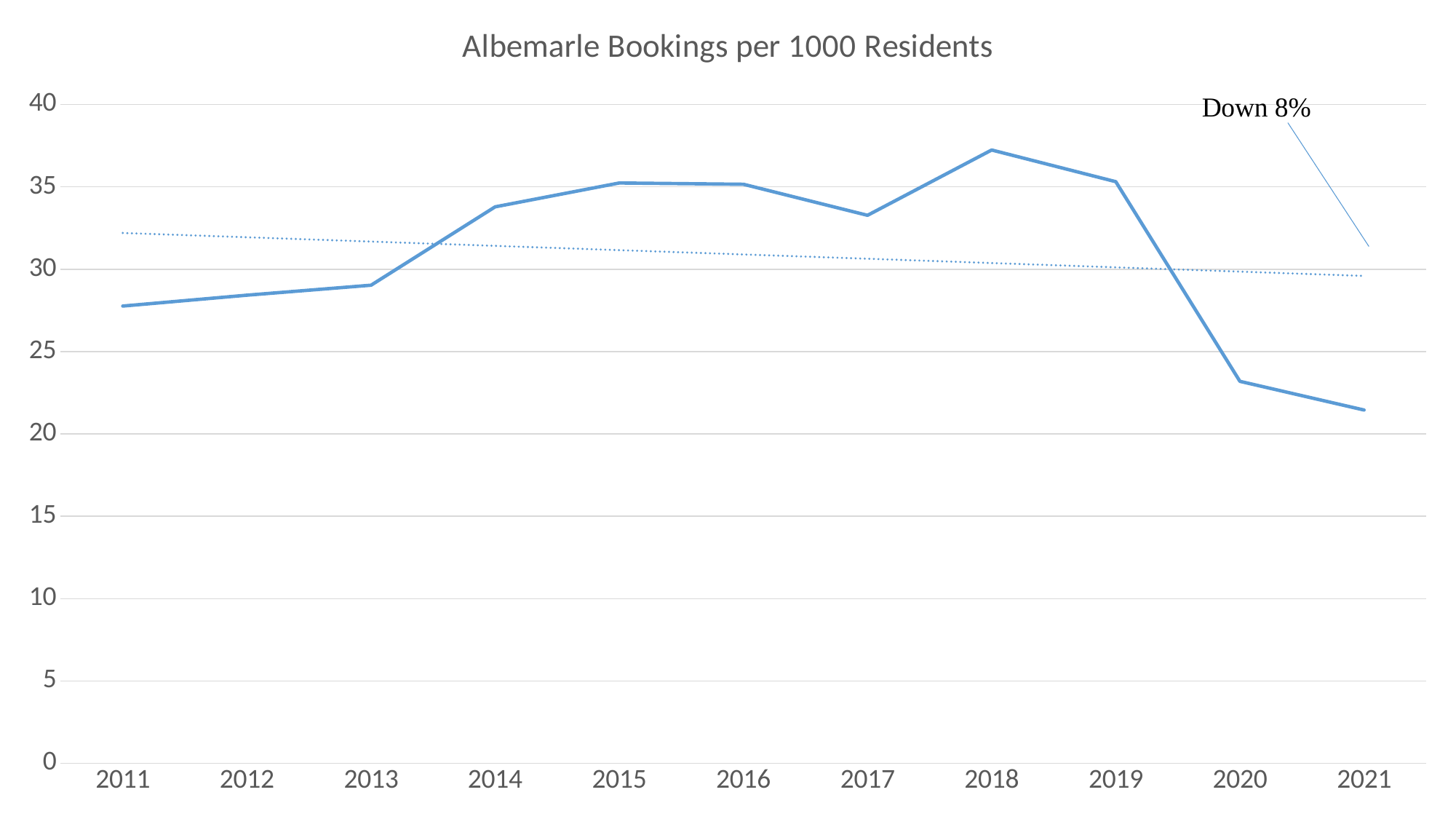
In which year is the bookings rate highest? 2018 Is the value for 2011 greater or less than 30? less What does the annotation near the 2021 end of the line say? Down 8% How many years are shown on the x axis? 11 Which year has the higher value, 2018 or 2019? 2018 What kind of chart is shown on the slide? Line chart Is the value for 2018 greater or less than 35? greater Do the values rise or fall from 2019 to 2021? fall In which year is the bookings rate lowest? 2021 What is the title of the chart? Albemarle Bookings per 1000 Residents Is the value for 2014 greater or less than 30? greater